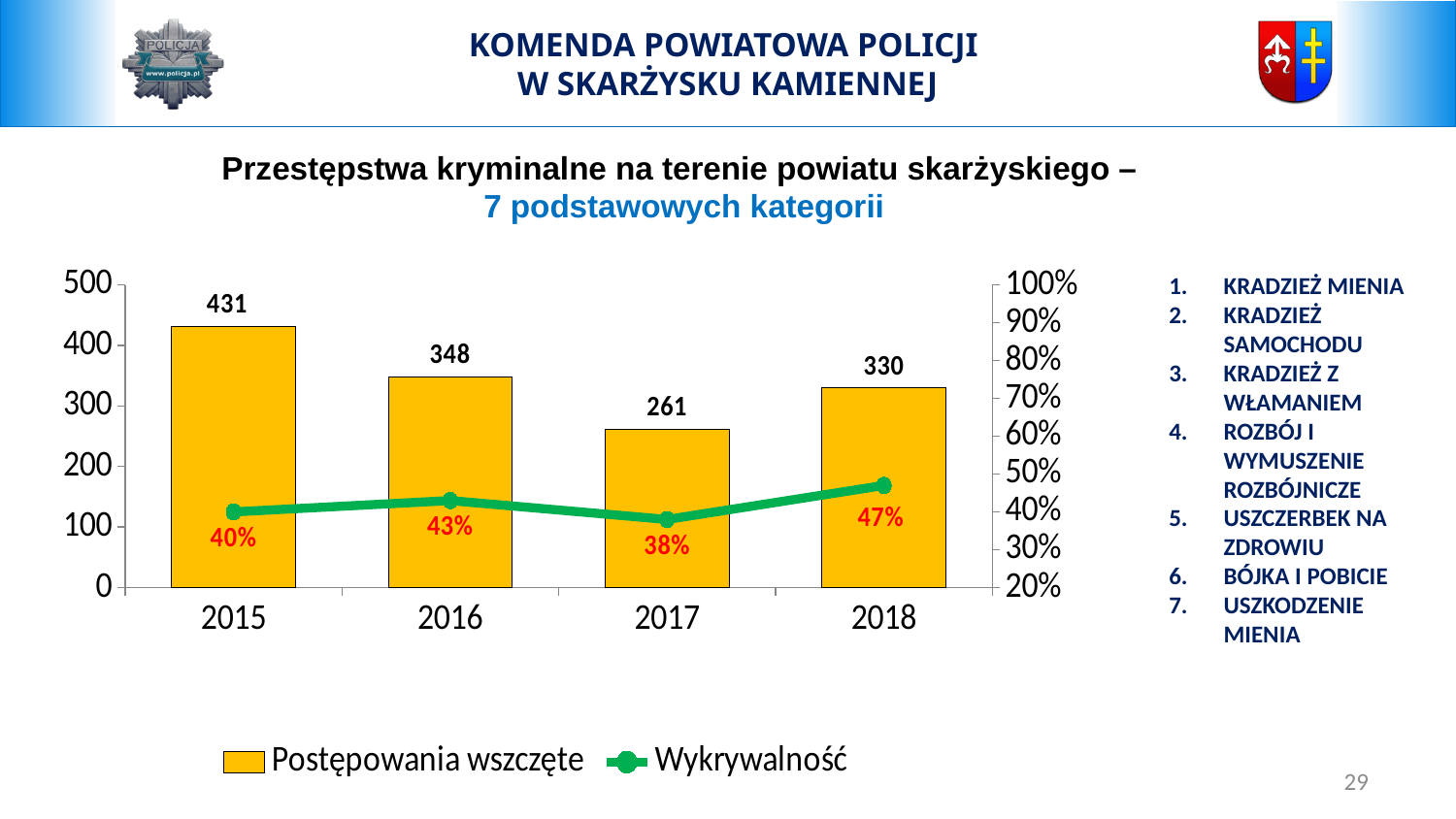
How many series does the legend list? 2 Which is larger, Postępowania wszczęte in 2016 or in 2018? 2016 What is the value of Postępowania wszczęte for 2015? 431 What is the value of Postępowania wszczęte for 2017? 261 Which year has the highest value of Postępowania wszczęte? 2015 What colour are the Postępowania wszczęte bars? yellow What is the difference between Postępowania wszczęte in 2015 and 2016? 83 What is the Wykrywalność value for 2018? 47% How many years are shown on the x axis? 4 Does Wykrywalność rise or fall from 2017 to 2018? rise Which year has the lowest Wykrywalność? 2017 What kind of chart is used for the Postępowania wszczęte series? bar chart